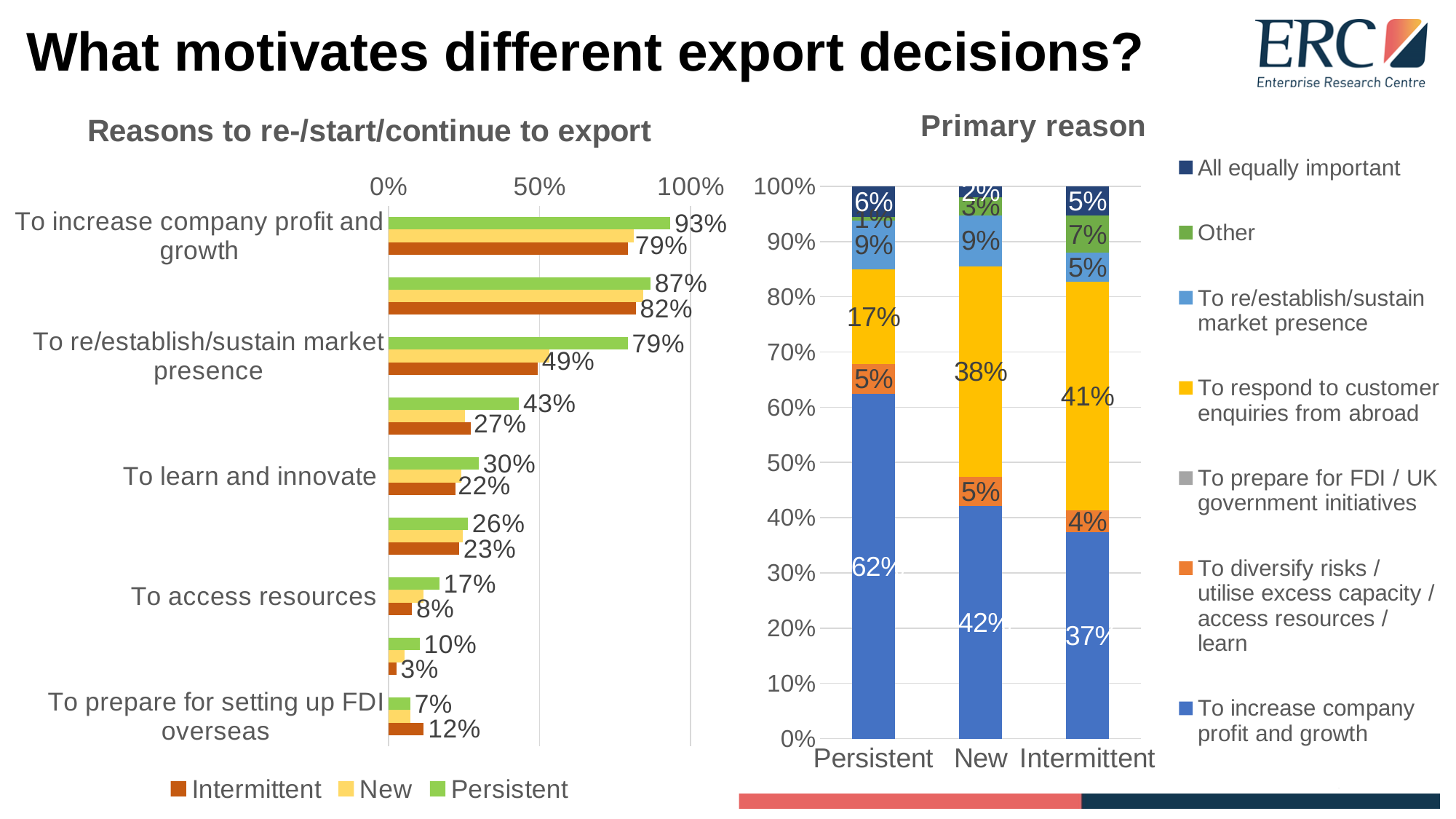
In the 'Primary reason' chart, what is the value for 'To respond to customer enquiries from abroad' in the Intermittent bar? 41% In the 'Primary reason' chart, what percentage of Persistent exporters cite 'To increase company profit and growth'? 62% In the 'Reasons to re-/start/continue to export' chart, how many series does the legend list? 3 In the 'Primary reason' chart, what is the value for 'To respond to customer enquiries from abroad' in the New bar? 38% In the 'Primary reason' chart, what is the difference between the Persistent and New values for 'To increase company profit and growth'? 20 percentage points In the 'Reasons to re-/start/continue to export' chart, what is the Intermittent value for 'To re/establish/sustain market presence'? 49% In the 'Reasons to re-/start/continue to export' chart, for 'To prepare for setting up FDI overseas', which is larger: the Persistent value or the Intermittent value? Intermittent What kind of chart is the 'Primary reason' chart? Stacked bar chart In the 'Primary reason' chart, which exporter group has the highest share for 'To increase company profit and growth'? Persistent In the 'Primary reason' chart, how many series does the legend list? 7 In the 'Reasons to re-/start/continue to export' chart, what is the Persistent value for 'To increase company profit and growth'? 93% In the 'Primary reason' chart, how many exporter groups are shown on the x axis? 3